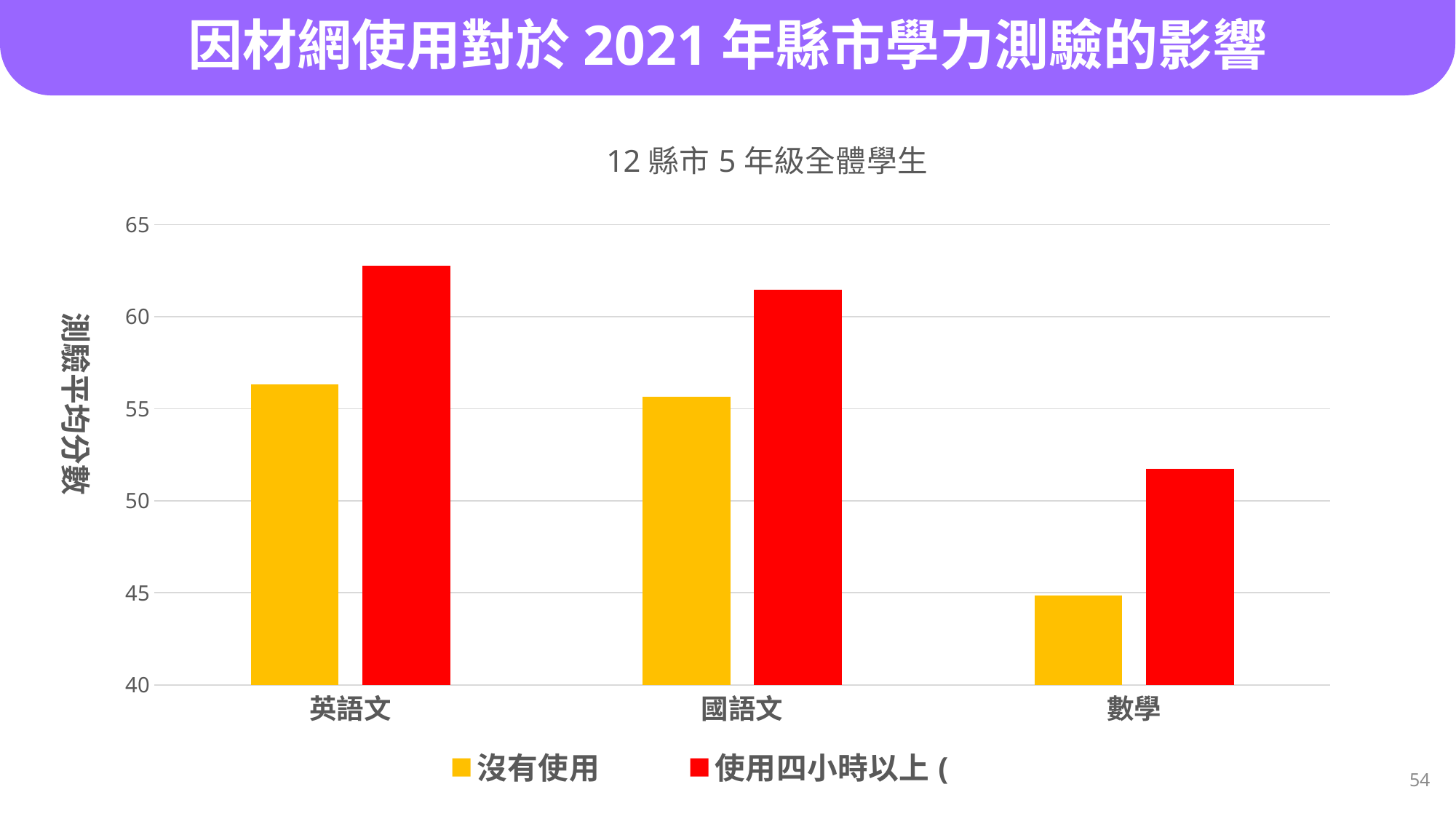
What kind of chart is shown on the slide? bar chart What is the chart's title? 12 縣市 5 年級全體學生 Which subject has the lowest bar for 沒有使用? 數學 How many subject categories are shown on the x axis? 3 How many series does the legend list? 2 Is the value for 英語文 沒有使用 greater or less than 55? greater Is the value for 國語文 使用四小時以上 greater or less than 60? greater Which subject has the highest bar for 使用四小時以上? 英語文 Is the value for 數學 沒有使用 greater or less than 50? less Do the 使用四小時以上 values rise or fall from 英語文 to 數學 along the x axis? fall Which subject has the lowest bar for 使用四小時以上? 數學 For 數學, which is larger: 沒有使用 or 使用四小時以上? 使用四小時以上